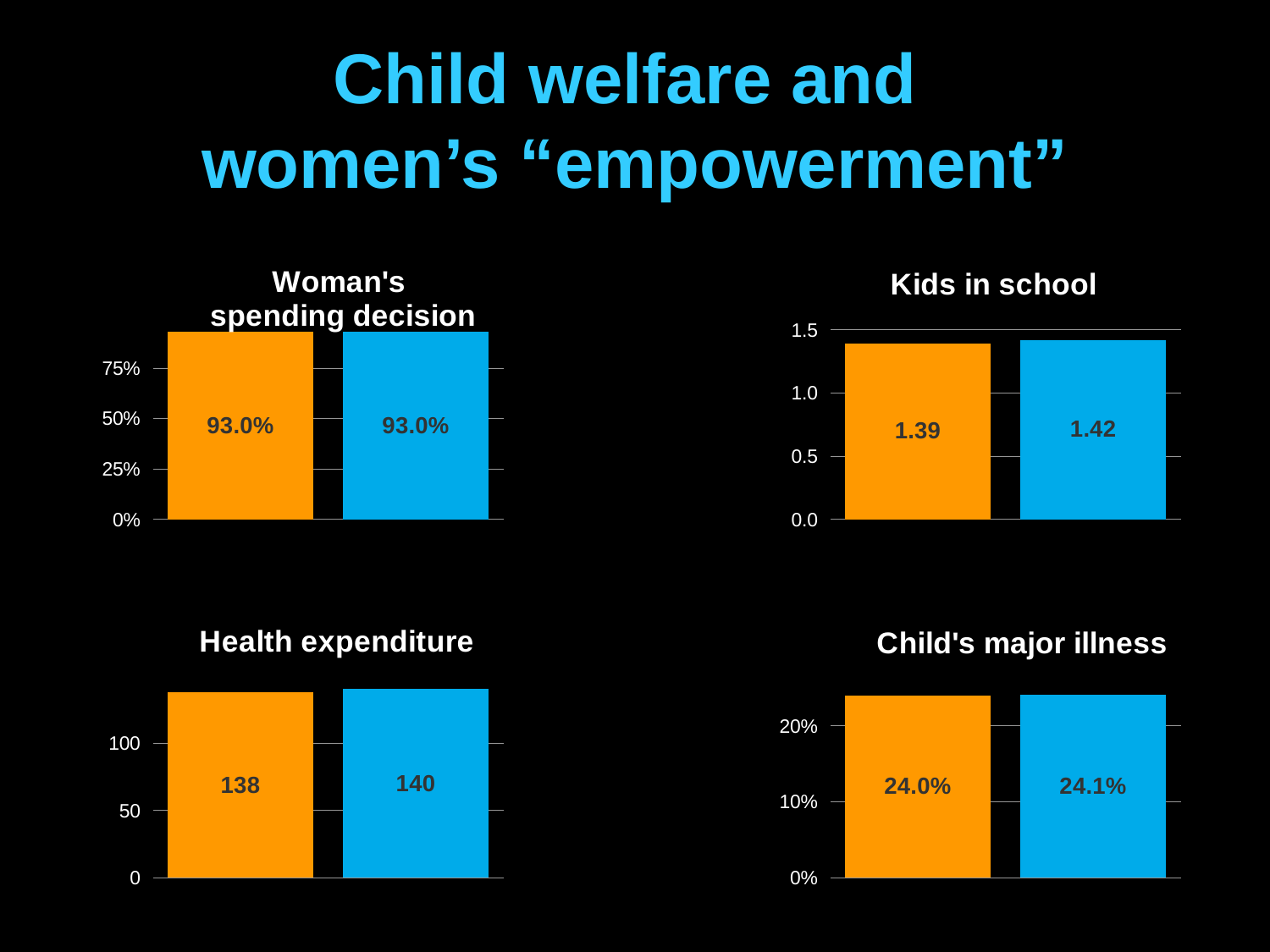
In the "Child's major illness" chart, what value is printed on the blue (right) bar? 24.1% In the "Woman's spending decision" chart, what value is printed on the blue bar? 93.0% In the "Health expenditure" chart, is the value of the orange bar greater or less than 100? greater In the "Health expenditure" chart, what is the difference between the blue bar's value and the orange bar's value? 2 In the "Health expenditure" chart, what value is printed on the blue (right) bar? 140 In the "Health expenditure" chart, what value is printed on the orange (left) bar? 138 In the "Kids in school" chart, what value is printed on the orange (left) bar? 1.39 What kind of chart is the "Kids in school" chart? bar chart In the "Kids in school" chart, what value is printed on the blue (right) bar? 1.42 In the "Child's major illness" chart, what value is printed on the orange (left) bar? 24.0% In the "Kids in school" chart, what is the difference between the blue bar's value and the orange bar's value? 0.03 In the "Woman's spending decision" chart, what value is printed on the orange bar? 93.0%